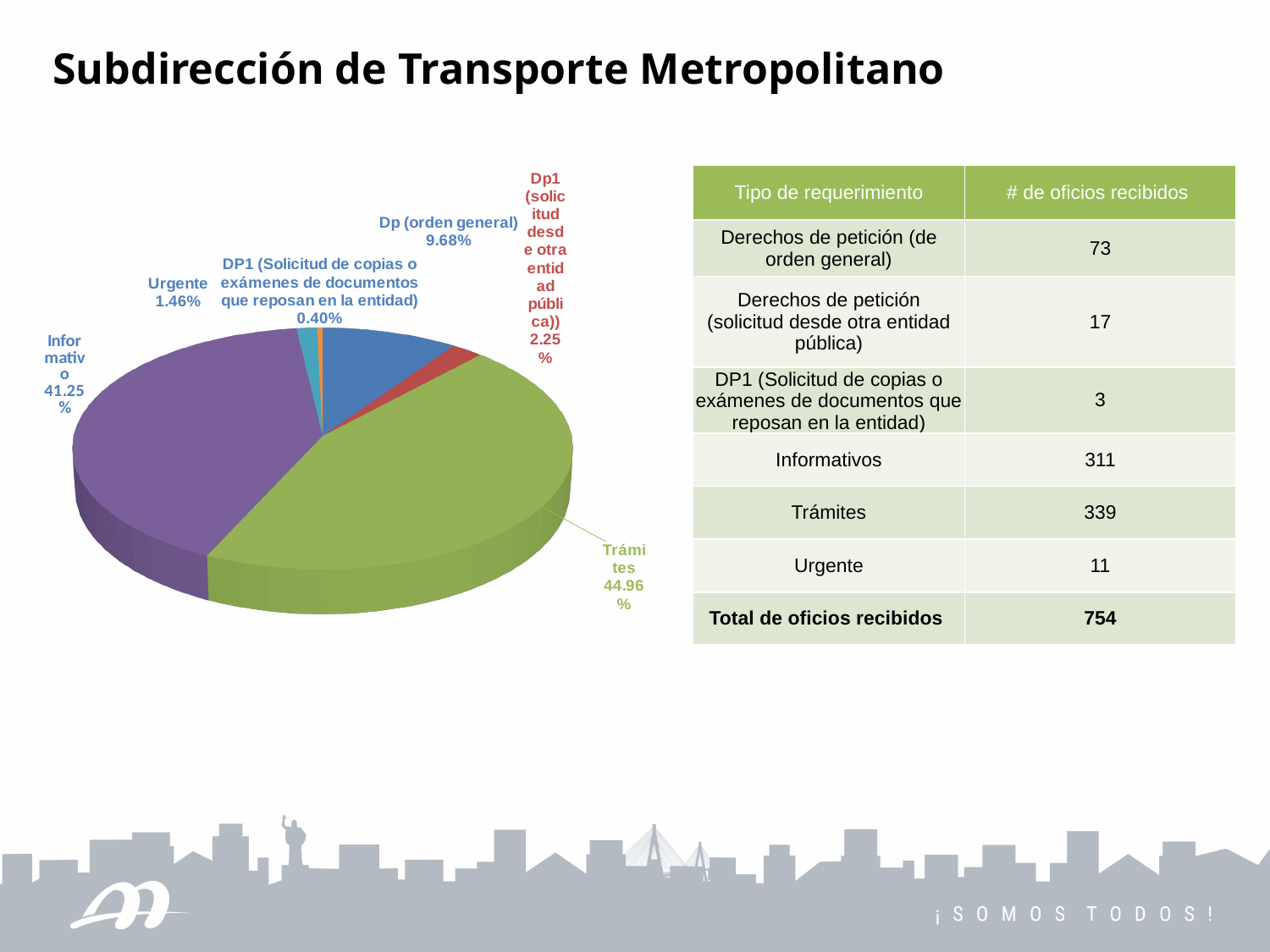
What colour is the Trámites slice in the pie chart? green In the pie chart, which is larger: Dp (orden general) or Dp1 (solicitud desde otra entidad pública)? Dp (orden general) What percentage does the pie chart show for Informativo? 41.25% Which category has the smallest slice in the pie chart? DP1 (Solicitud de copias o exámenes de documentos que reposan en la entidad) What is the difference in percentage points between Trámites and Informativo in the pie chart? 3.71 What percentage does the pie chart show for Dp (orden general)? 9.68% What percentage does the pie chart show for DP1 (Solicitud de copias o exámenes de documentos que reposan en la entidad)? 0.40% What kind of chart is shown on the slide? pie chart How many slices does the pie chart have? 6 What percentage does the pie chart show for Trámites? 44.96% What percentage does the pie chart show for Urgente? 1.46% Which category has the largest slice in the pie chart? Trámites